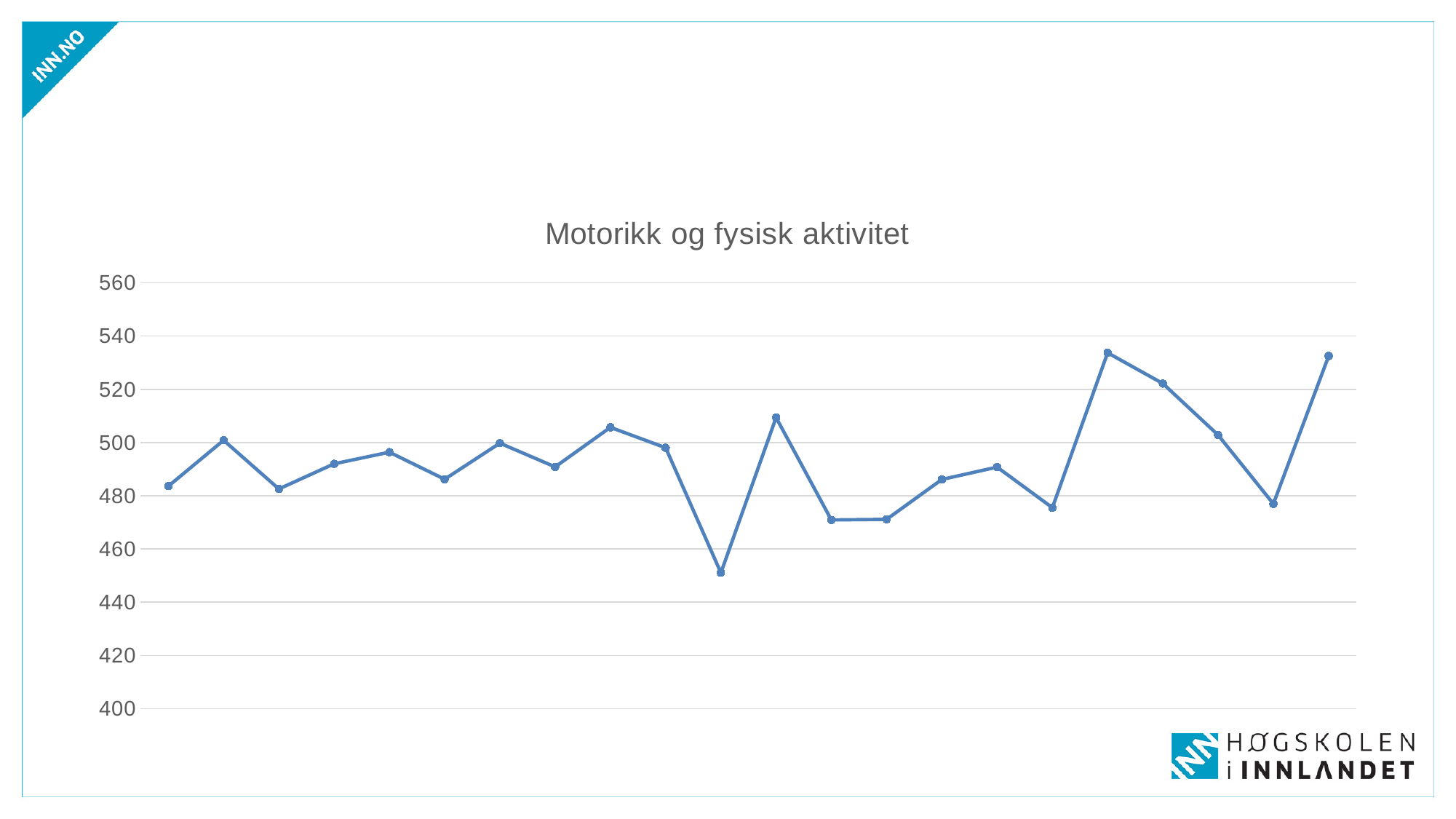
Is the value of the first (leftmost) point greater or less than 500? less How many data points are plotted on the line? 22 Is the value of the lowest point on the line greater or less than 460? less Does the line end higher or lower than it starts? higher Which is larger, the value of the first point or the value of the last point? the last point Is the value of the highest point on the line greater or less than 520? greater What is the title of the chart? Motorikk og fysisk aktivitet What is the highest value shown on the y axis? 560 What kind of chart is shown on the slide? line chart